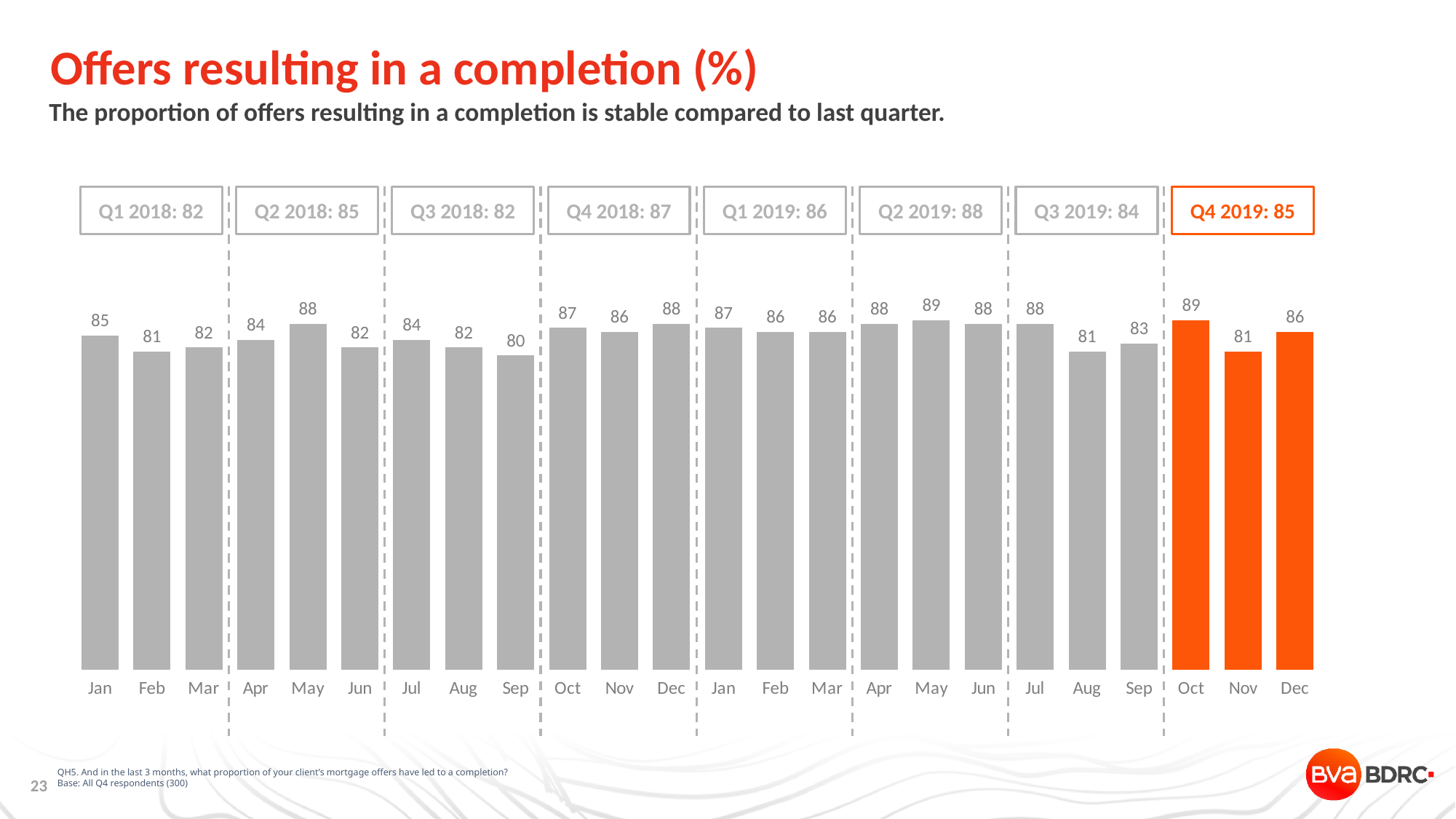
What is the value for Sep 2018? 80 What is the difference between the Q2 2019 quarterly figure and the Q3 2019 quarterly figure? 4 What is the value for Oct 2019 (the first orange bar)? 89 Which month has the lowest value on the chart? Sep 2018 What is the difference between the values for Oct 2019 and Nov 2019? 8 Which bars are coloured orange rather than grey? Oct, Nov and Dec 2019 (Q4 2019) How many monthly bars are plotted on the chart? 24 What is the value for Nov 2019? 81 What is the highest monthly value shown on the chart? 89 What kind of chart is shown on the slide? Bar chart What quarterly figure is shown in the box for Q4 2019? 85 Which is larger, the value for Dec 2019 or the value for Dec 2018? Dec 2018